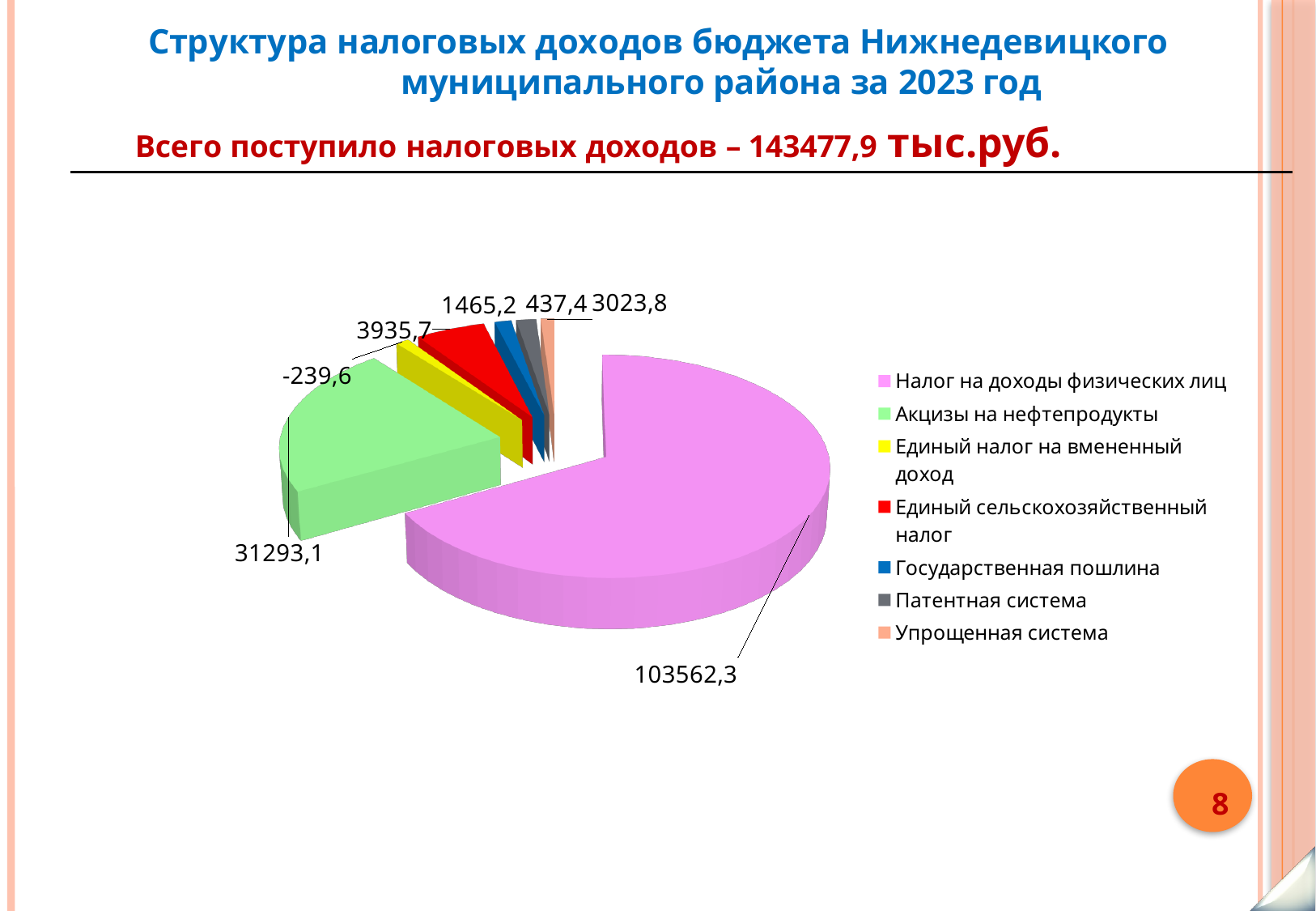
What is the value for Единый сельскохозяйственный налог? 3935,7 What kind of chart is shown on the slide? Pie chart How many categories does the legend of the pie chart list? 7 What total amount of tax revenue does the slide state was received? 143477,9 тыс.руб. Which is larger: the value for Государственная пошлина or the value for Патентная система? Государственная пошлина What is the value for Упрощенная система? 3023,8 What is the difference between the values for Налог на доходы физических лиц and Акцизы на нефтепродукты? 72269,2 What is the value for Государственная пошлина? 1465,2 Which category has the largest value in the pie chart? Налог на доходы физических лиц What is the value for Акцизы на нефтепродукты? 31293,1 What is the value for Патентная система? 437,4 What is the value for Налог на доходы физических лиц? 103562,3